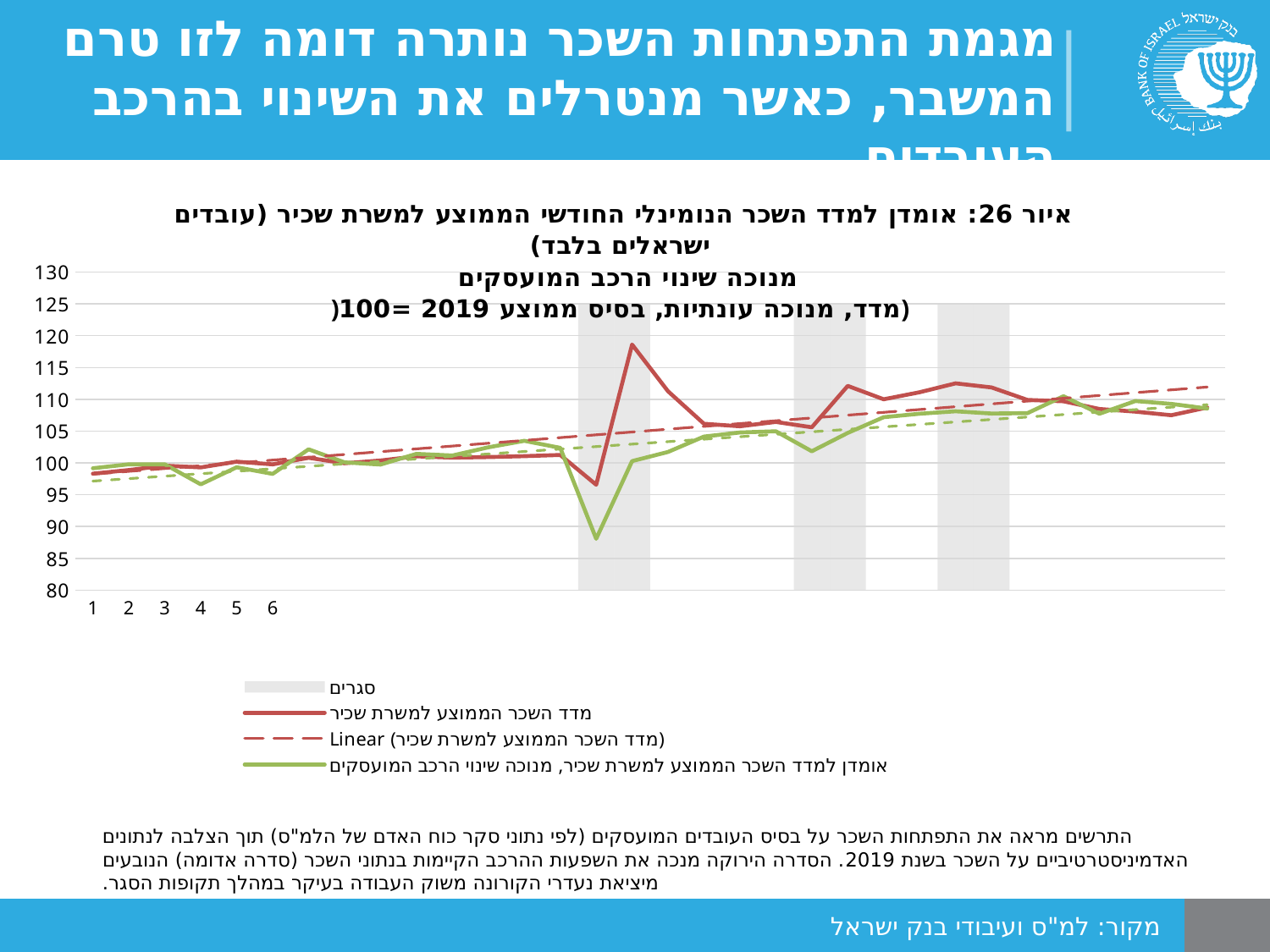
Is the value of the red line at the right end of the chart greater or less than 105? greater What is the highest value shown on the vertical axis? 130 Is the peak of the red line (מדד השכר הממוצע למשרת שכיר) in the first shaded period greater or less than 115? greater Is the lowest point of the red line in the first shaded period greater or less than 100? less What kind of chart is shown on the slide? line chart Overall, does the dashed linear trend line (Linear) rise or fall from left to right? rise What is the base value of the index according to the chart subtitle (בסיס ממוצע 2019)? 100 How many entries does the legend list? 4 What is the figure number given in the chart title? איור 26 At the lowest point in the first shaded period, which line is lower: the red line or the green line? the green line